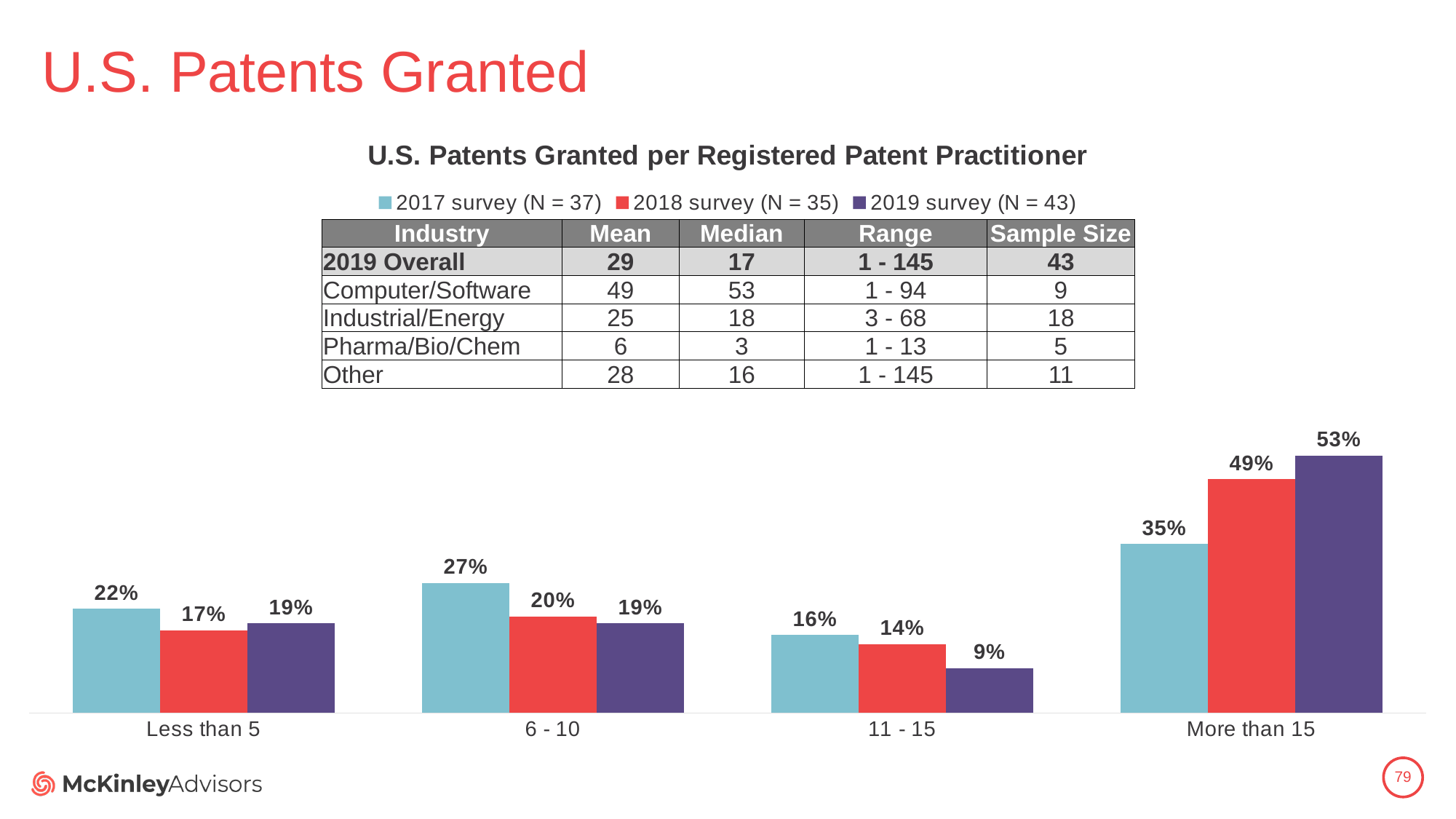
How many series does the chart legend list? 3 What is the value for the 2019 survey in the 'More than 15' category? 53% What is the value for the 2017 survey in the '6 - 10' category? 27% Which category has the lowest value for the 2019 survey? 11 - 15 What is the difference between the 2019 survey and 2017 survey values in the 'More than 15' category? 18% Which category has the highest value for the 2019 survey? More than 15 What is the title of the chart? U.S. Patents Granted per Registered Patent Practitioner How many categories are shown on the x axis of the chart? 4 What kind of chart is shown on the slide? Bar chart Which is larger in the 'Less than 5' category: the 2017 survey value or the 2018 survey value? 2017 survey What is the value for the 2018 survey in the '11 - 15' category? 14% Do the 2019 survey values rise or fall from '6 - 10' to '11 - 15'? Fall